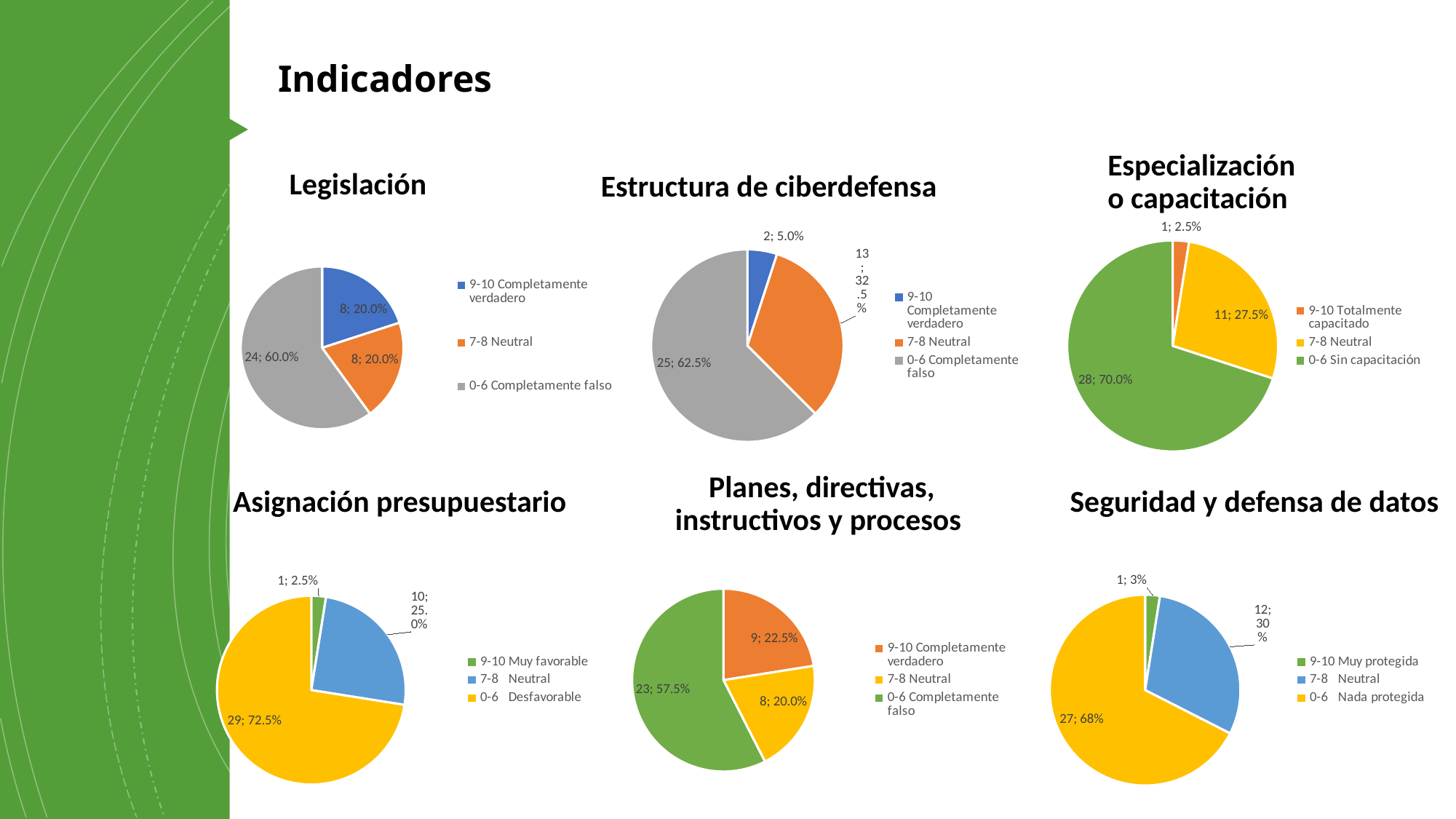
In the 'Especialización o capacitación' chart, what is the difference in count between '0-6 Sin capacitación' and '7-8 Neutral'? 17 In the 'Estructura de ciberdefensa' chart, which category has the smallest slice? 9-10 Completamente verdadero How many categories does the legend of the 'Seguridad y defensa de datos' chart list? 3 In the 'Legislación' chart, what share of the pie does '0-6 Completamente falso' take? 60.0% What type of chart is used for 'Legislación'? Pie chart In the 'Legislación' chart, how many responses are labelled for '7-8 Neutral'? 8 In the 'Especialización o capacitación' chart, what is the count shown for '0-6 Sin capacitación'? 28 In the 'Asignación presupuestario' chart, what percentage is shown for '9-10 Muy favorable'? 2.5% In the 'Seguridad y defensa de datos' chart, what percentage is shown for '0-6 Nada protegida'? 68% In the 'Planes, directivas, instructivos y procesos' chart, which is larger: '9-10 Completamente verdadero' or '7-8 Neutral'? 9-10 Completamente verdadero In the 'Asignación presupuestario' chart, which category has the largest slice? 0-6 Desfavorable